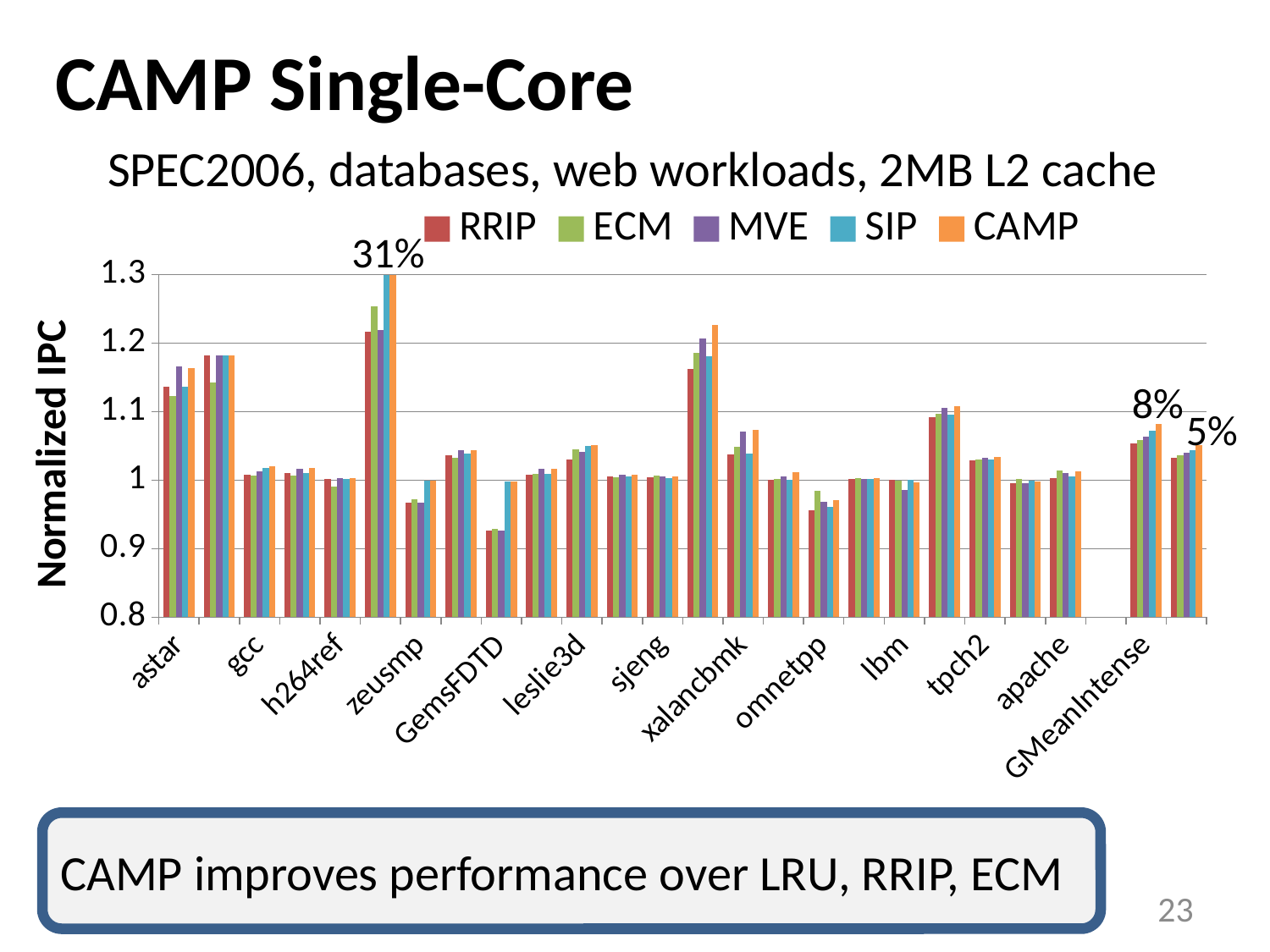
What is the label on the vertical axis? Normalized IPC What kind of chart is shown on the slide? bar chart What are the series names listed in the legend? RRIP, ECM, MVE, SIP, CAMP What percentage is annotated above the second-to-last group of bars on the right? 8% What percentage is annotated above the rightmost group of bars? 5% Is the RRIP value in the group annotated 31% greater or less than 1.3? less Which group of bars reaches the highest Normalized IPC on the chart? the group annotated 31% How many series does the legend list? 5 What percentage is annotated above the tallest group of bars? 31% Is the CAMP value in the group annotated 31% greater or less than 1.2? greater Is the CAMP value in the group annotated 5% greater or less than 1? greater